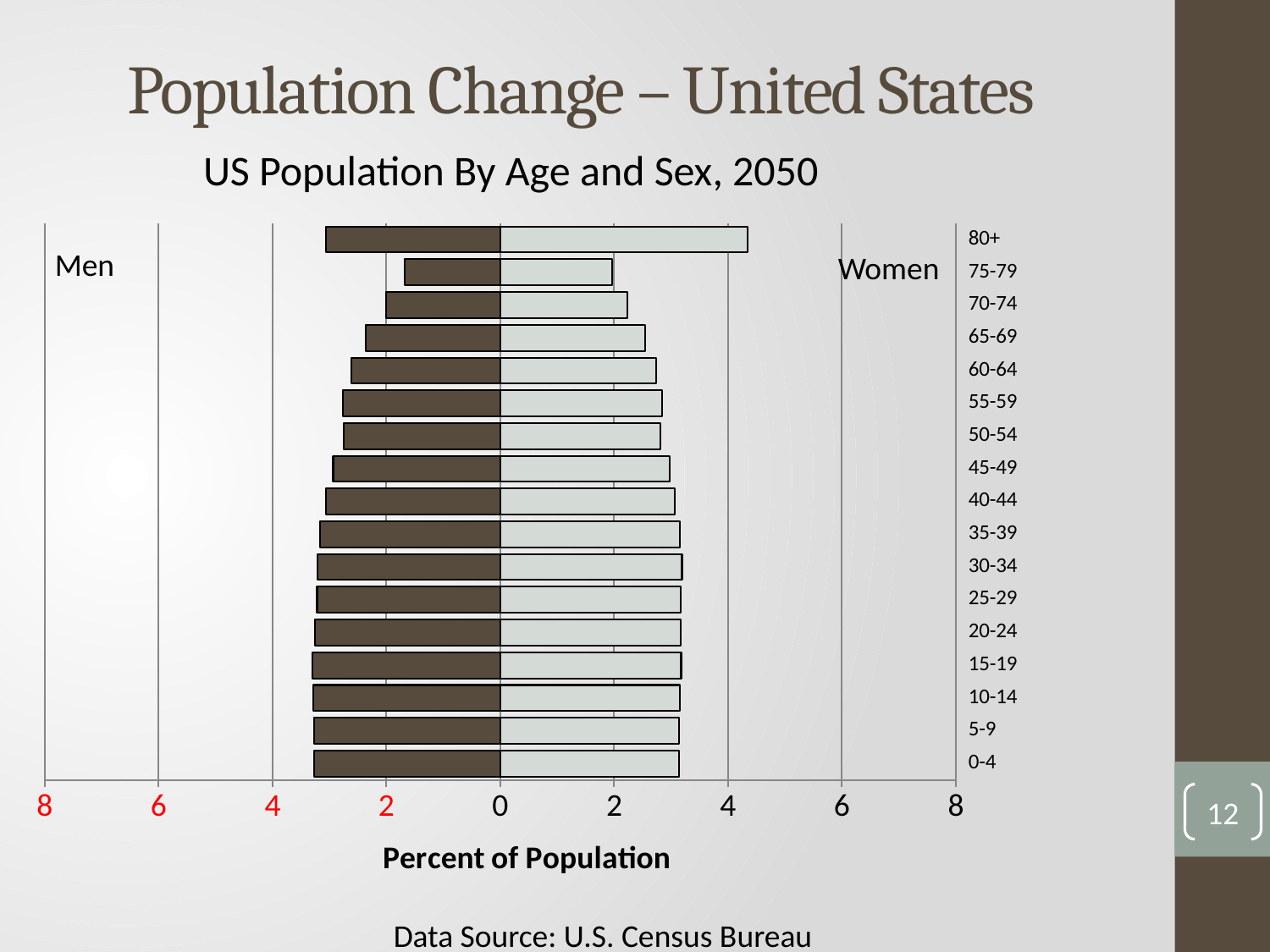
Is the Men value for the 0-4 age group greater or less than 4? less Which age group has the shortest Men bar? 75-79 What kind of chart is shown on the slide? bar chart How many age groups are shown on the chart? 17 How many series (sexes) does the chart show? 2 Is the Women value for the 80+ age group greater or less than 4? greater Is the Men value for the 75-79 age group greater or less than 2? less What is the title of the chart's horizontal axis? Percent of Population Do the Men bars generally get shorter or longer moving from the 0-4 age group up to the 75-79 age group? shorter Which age group has the longest Women bar? 80+ For the 80+ age group, which is larger, the Men value or the Women value? Women